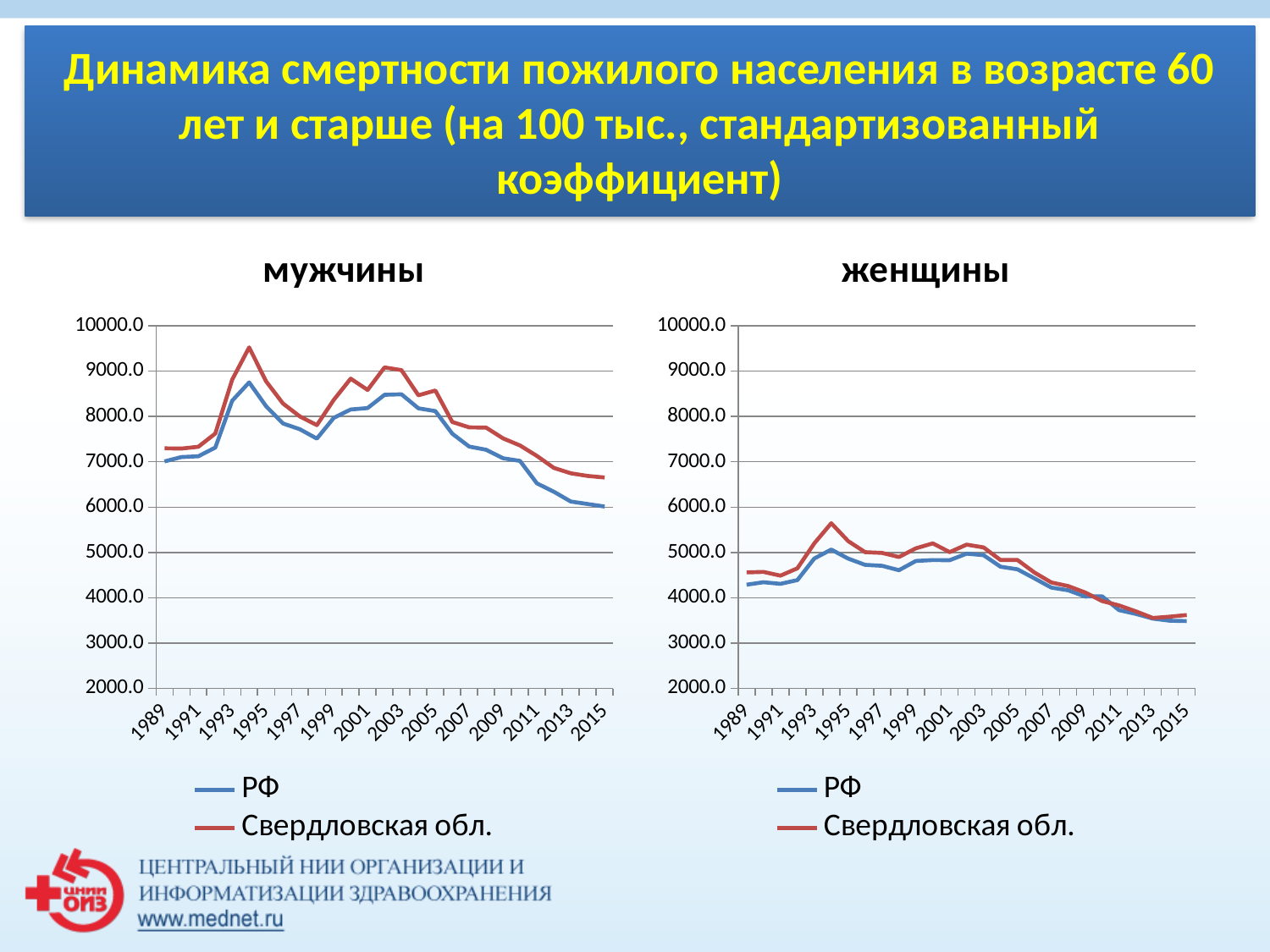
In the "женщины" chart, is the value for РФ in 1989 greater or less than 4000.0? greater In the "женщины" chart, do the values for Свердловская обл. rise or fall from 2003 to 2015? fall In the "мужчины" chart, do the values for РФ rise or fall from 2003 to 2015? fall In the "мужчины" chart, is the peak value for Свердловская обл. (around 1994) greater or less than 9000.0? greater What kind of chart is the "мужчины" chart? line chart In the "мужчины" chart, what colour is the line for РФ? blue In the "мужчины" chart, is the peak value for РФ (around 1994) greater or less than 9000.0? less In the "женщины" chart, which series has the higher value in 1994, РФ or Свердловская обл.? Свердловская обл. In the "мужчины" chart, which series has the higher value in 1994, РФ or Свердловская обл.? Свердловская обл. How many series does the legend of the "женщины" chart list? 2